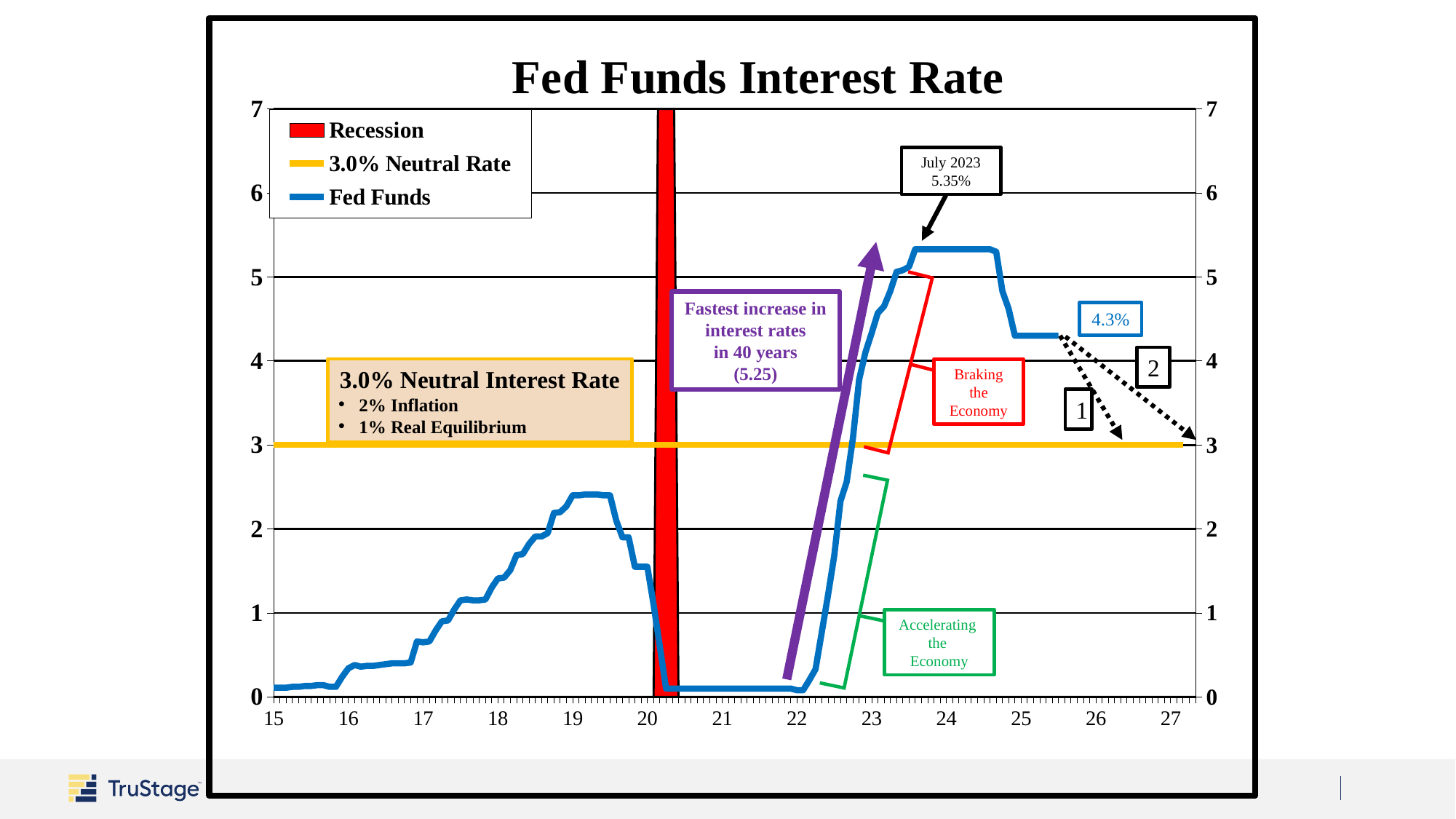
What does the red vertical bar on the chart represent, according to the legend? Recession What Fed Funds rate is labeled for July 2023? 5.35% What is the title of the chart? Fed Funds Interest Rate Is the Fed Funds rate at its 2019 peak greater or less than 3? less What is the value of the neutral interest rate shown as the horizontal yellow line? 3.0% Is the Fed Funds rate during 2021 greater or less than 1? less How many entries does the chart's legend list? 3 What kind of chart is shown on the slide? line chart What is the difference between the July 2023 rate of 5.35% and the latest labeled rate of 4.3%? 1.05 percentage points What is the most recent Fed Funds rate labeled on the chart, at the end of the blue line? 4.3% Does the Fed Funds rate rise or fall between 2022 and 2023? rise Which is larger, the Fed Funds rate in July 2023 or the latest labeled Fed Funds rate of 4.3%? July 2023